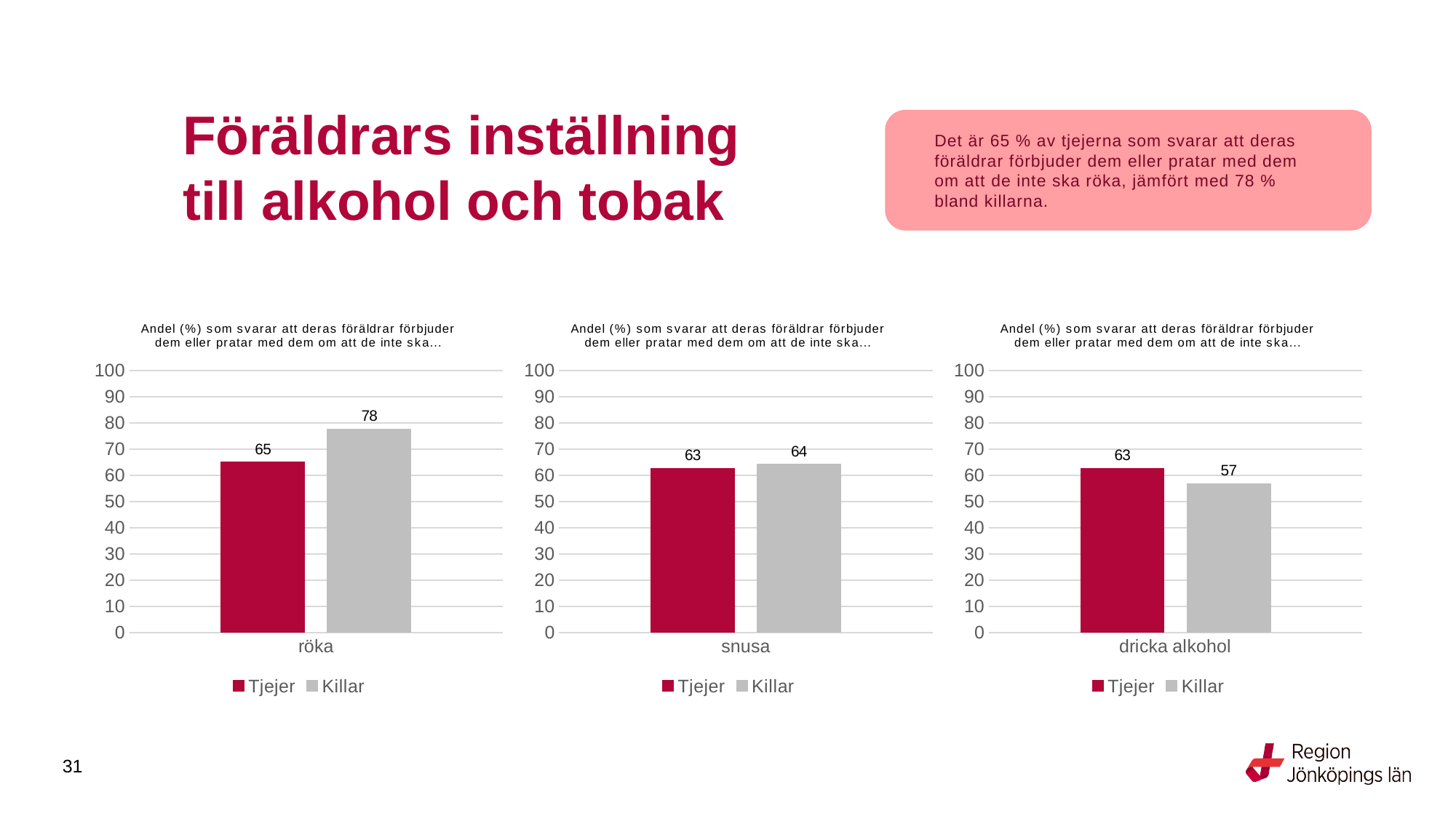
In the left chart (röka), what is the value for Killar? 78 What kind of chart is the middle chart (snusa)? Bar chart In the right chart (dricka alkohol), what is the value for Tjejer? 63 In the right chart (dricka alkohol), which series has the higher value, Tjejer or Killar? Tjejer In the right chart (dricka alkohol), what is the difference between the Tjejer and Killar values? 6 In the middle chart (snusa), what is the value for Killar? 64 In the right chart (dricka alkohol), what is the value for Killar? 57 In the left chart (röka), what is the difference between the Killar and Tjejer values? 13 In the middle chart (snusa), what is the difference between the Killar and Tjejer values? 1 In the left chart (röka), which series has the higher value, Tjejer or Killar? Killar How many series does the legend of the left chart (röka) list? 2 In the left chart (röka), what is the value for Tjejer? 65